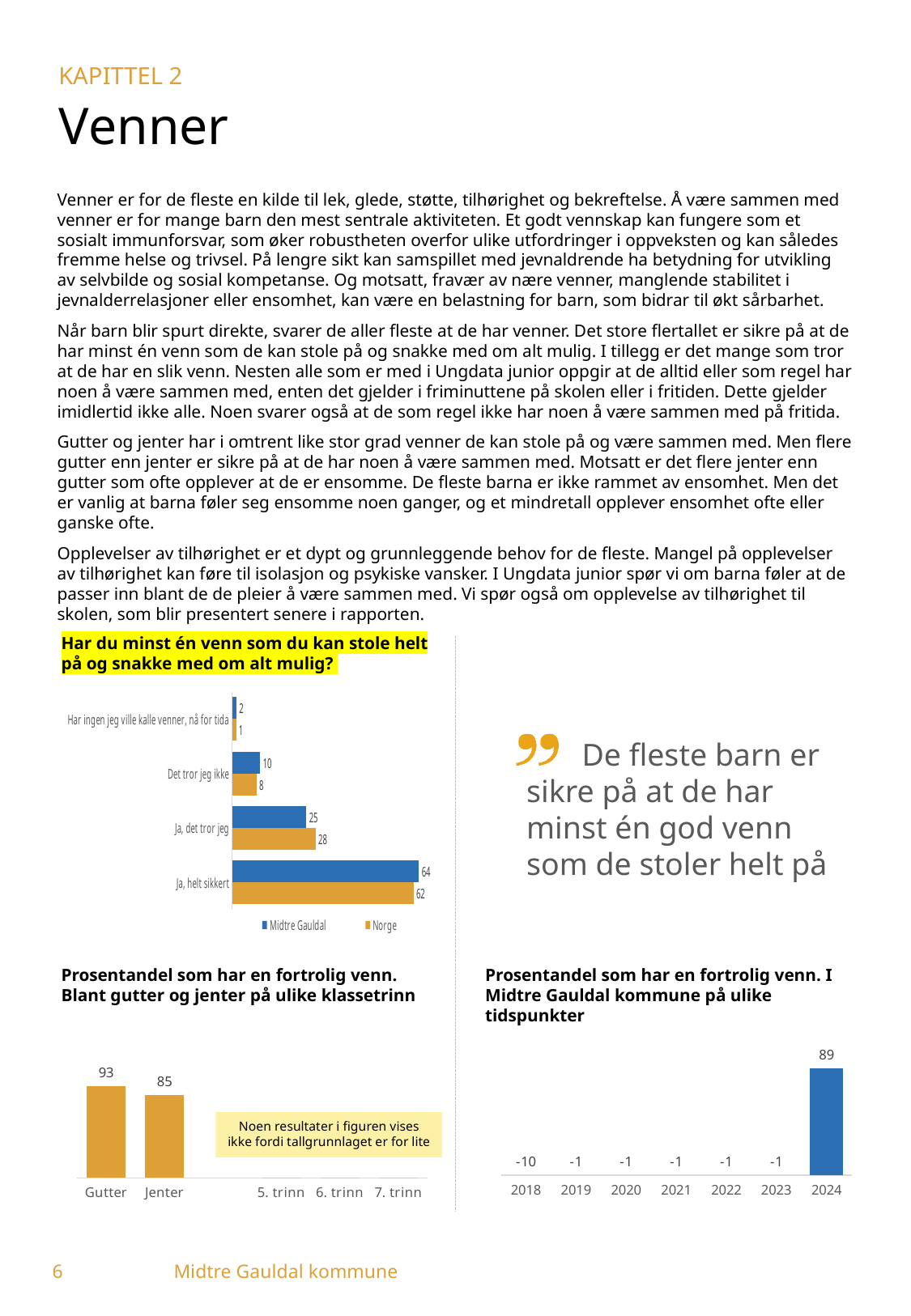
How many categories are shown in the chart titled "Har du minst én venn som du kan stole helt på og snakke med om alt mulig?"? 4 In the chart titled "Prosentandel som har en fortrolig venn. Blant gutter og jenter på ulike klassetrinn", what is the difference between Gutter and Jenter? 8 In the chart titled "Har du minst én venn som du kan stole helt på og snakke med om alt mulig?", which category has the highest value for Midtre Gauldal? Ja, helt sikkert In the chart titled "Har du minst én venn som du kan stole helt på og snakke med om alt mulig?", what is the value for Norge for "Ja, det tror jeg"? 28 How many series does the legend list in the chart titled "Har du minst én venn som du kan stole helt på og snakke med om alt mulig?"? 2 In the chart titled "Har du minst én venn som du kan stole helt på og snakke med om alt mulig?", which is larger for "Ja, det tror jeg": Midtre Gauldal or Norge? Norge In the chart titled "Prosentandel som har en fortrolig venn. Blant gutter og jenter på ulike klassetrinn", what is the value for Gutter? 93 In the chart titled "Har du minst én venn som du kan stole helt på og snakke med om alt mulig?", what is the value for Midtre Gauldal for "Ja, helt sikkert"? 64 In the chart titled "Har du minst én venn som du kan stole helt på og snakke med om alt mulig?", which category has the lowest value for Norge? Har ingen jeg ville kalle venner, nå for tida In the chart titled "Prosentandel som har en fortrolig venn. I Midtre Gauldal kommune på ulike tidspunkter", what is the value for 2024? 89 In the chart titled "Har du minst én venn som du kan stole helt på og snakke med om alt mulig?", what is the difference between Midtre Gauldal and Norge for "Det tror jeg ikke"? 2 What kind of chart is the one titled "Prosentandel som har en fortrolig venn. Blant gutter og jenter på ulike klassetrinn"? Bar chart